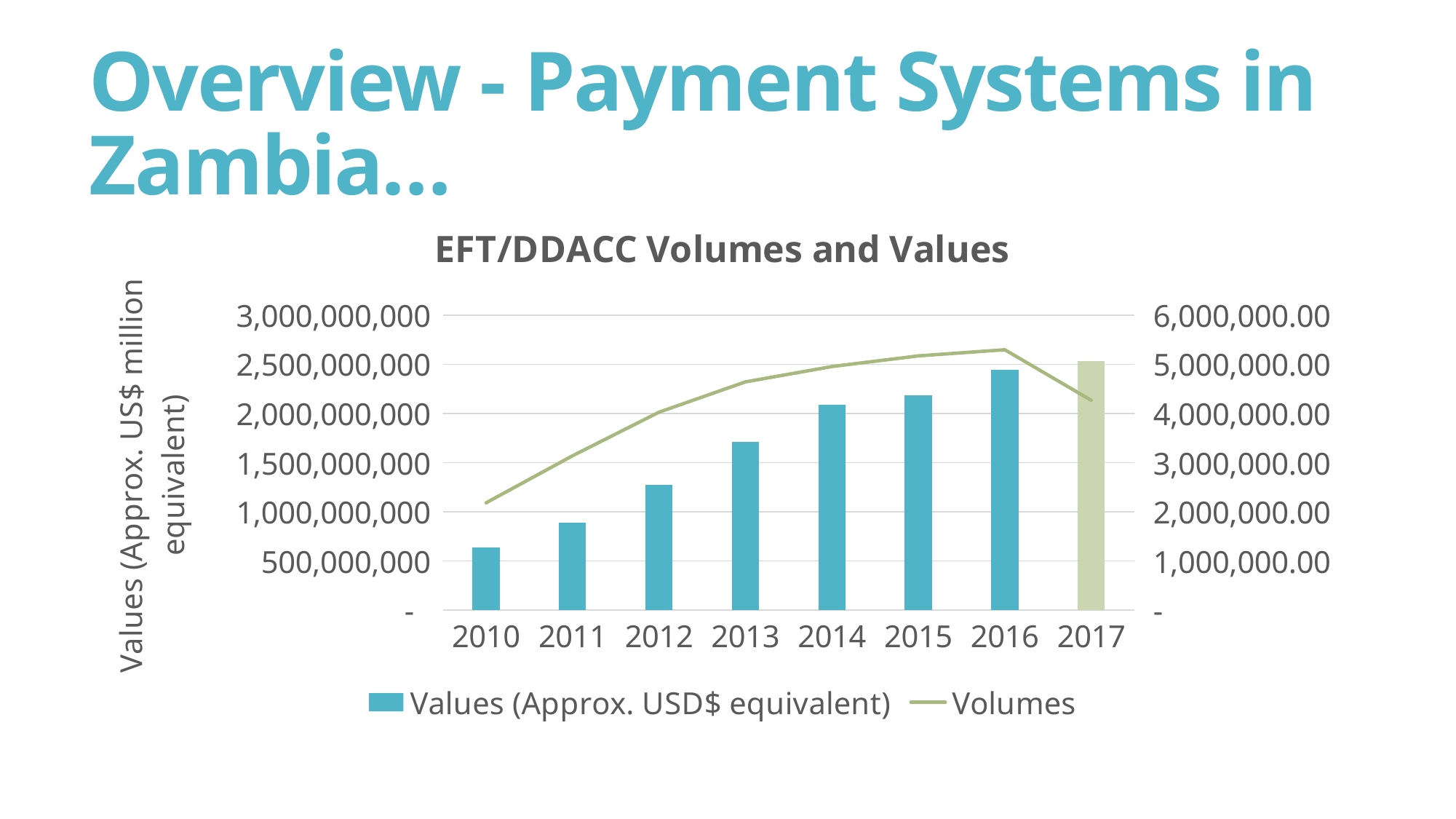
Do the Values bars generally rise or fall from 2010 to 2017? rise Which year has the lowest bar for Values (Approx. USD$ equivalent)? 2010 Is the Values bar for 2016 greater or less than 2,000,000,000? greater Which year has a larger Values bar, 2012 or 2015? 2015 How many series does the legend list? 2 How many years are shown on the x axis? 8 Which year has the highest bar for Values (Approx. USD$ equivalent)? 2017 Is the Volumes value for 2017 greater or less than 5,000,000.00? less What kind of chart is shown on the slide? A combined bar and line chart Is the Values bar for 2013 greater or less than 1,500,000,000? greater What is the title of the chart? EFT/DDACC Volumes and Values